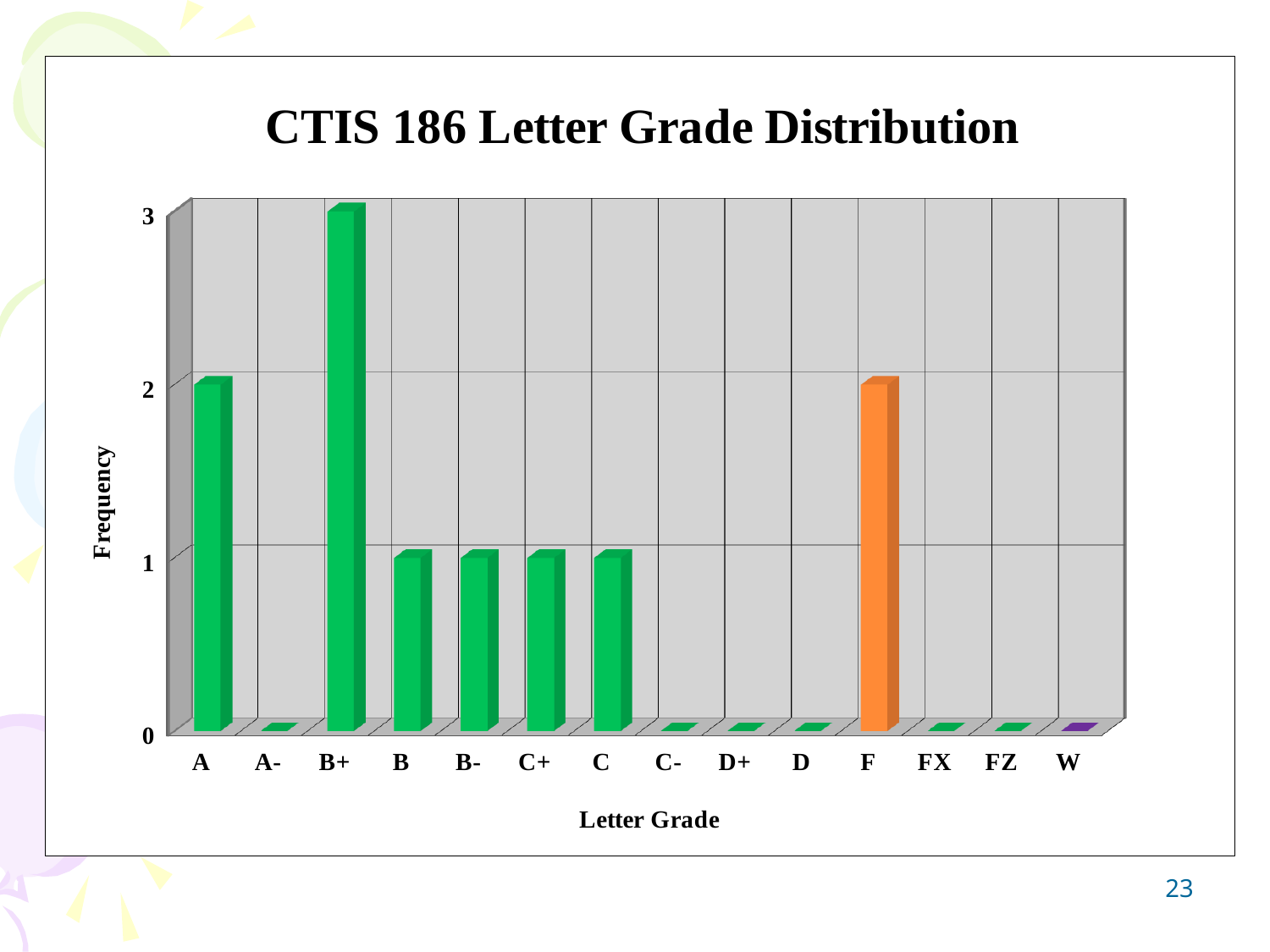
Which has a higher frequency, B or F? F What is the frequency for the letter grade C+? 1 What is the difference in frequency between B+ and A? 1 What is the frequency for the letter grade F? 2 What is the label of the y axis? Frequency What is the frequency for the letter grade D? 0 What is the frequency for the letter grade B+? 3 What is the frequency for the letter grade A? 2 Which letter grade has the highest frequency? B+ How many letter grade categories are shown on the x axis? 14 What type of chart is shown on the slide? bar chart What is the title of the chart? CTIS 186 Letter Grade Distribution